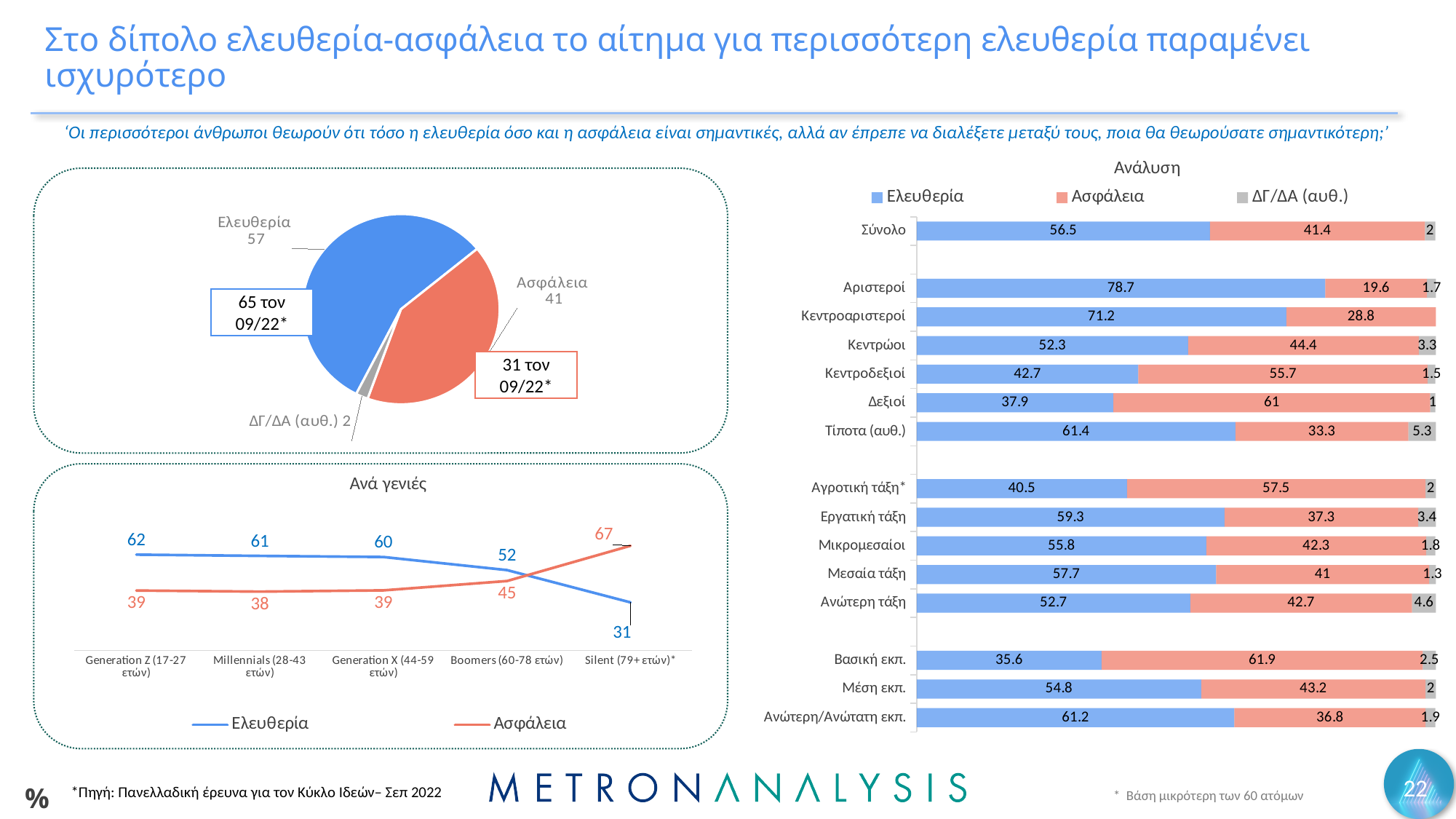
What kind of chart is the 'Ανά γενιές' chart? line chart In the 'Ανά γενιές' chart, what is the difference between Ελευθερία and Ασφάλεια for Generation Z (17-27 ετών)? 23 In the pie chart on the left, what share of the pie does Ασφάλεια take? 41 In the 'Ανάλυση' chart, which category has the lowest Ελευθερία value? Βασική εκπ. In the 'Ανά γενιές' chart, how many generation categories are shown on the x axis? 5 How many series does the legend of the 'Ανάλυση' chart list? 3 In the 'Ανάλυση' chart, which is larger for Δεξιοί: Ελευθερία or Ασφάλεια? Ασφάλεια In the 'Ανά γενιές' chart, does the Ελευθερία line rise or fall from Generation Z to Silent? fall In the 'Ανάλυση' chart, what is the Ελευθερία value for Αριστεροί? 78.7 In the pie chart on the left, which slice is the smallest? ΔΓ/ΔΑ (αυθ.) In the 'Ανά γενιές' chart, what is the value of Ασφάλεια for Silent (79+ ετών)? 67 In the pie chart on the left, what is the value for Ελευθερία? 57